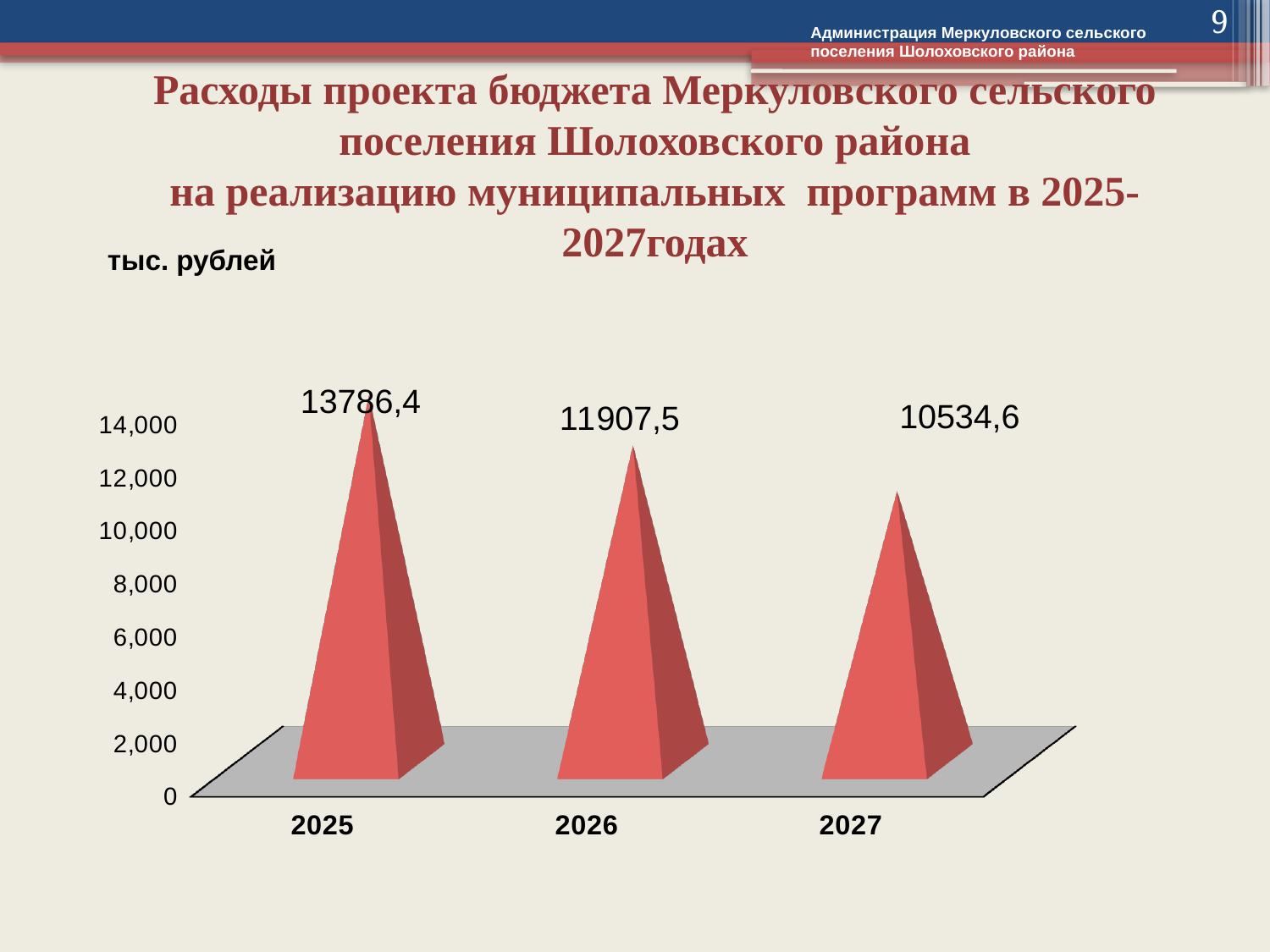
What is the value for 2025? 13786,4 What is the difference between the values for 2025 and 2026? 1878,9 Do the values rise or fall from 2025 to 2027? fall What kind of chart is shown on the slide? bar chart Which is larger, the value for 2025 or the value for 2027? 2025 What is the difference between the values for 2026 and 2027? 1372,9 Is the value for 2027 greater or less than 12,000? less What is the value for 2026? 11907,5 How many years are shown on the chart? 3 Which year has the lowest value? 2027 What is the value for 2027? 10534,6 Which year has the highest value? 2025